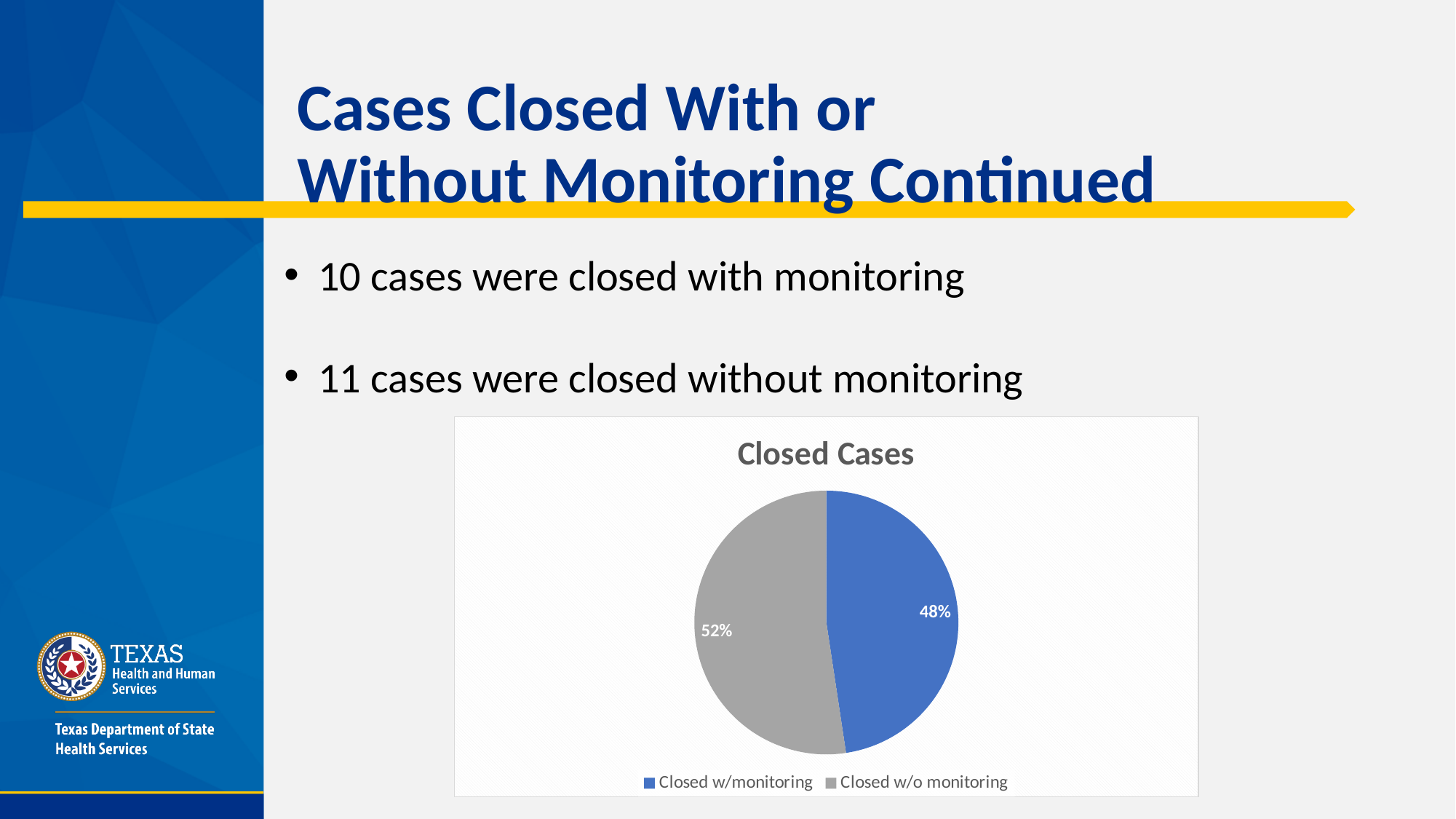
What type of chart is shown on the slide? pie chart What colour is the Closed w/o monitoring slice? gray Which is larger, the Closed w/monitoring slice or the Closed w/o monitoring slice? Closed w/o monitoring What is the title of the chart? Closed Cases Which slice of the pie is the smallest? Closed w/monitoring What percentage of the pie is labelled for Closed w/monitoring? 48% What percentage of the pie is labelled for Closed w/o monitoring? 52% Which slice of the pie is the largest? Closed w/o monitoring Is the share for Closed w/monitoring greater or less than 50%? less What is the difference in percentage points between the Closed w/o monitoring slice and the Closed w/monitoring slice? 4 How many entries does the legend list? 2 How many slices does the pie chart have? 2